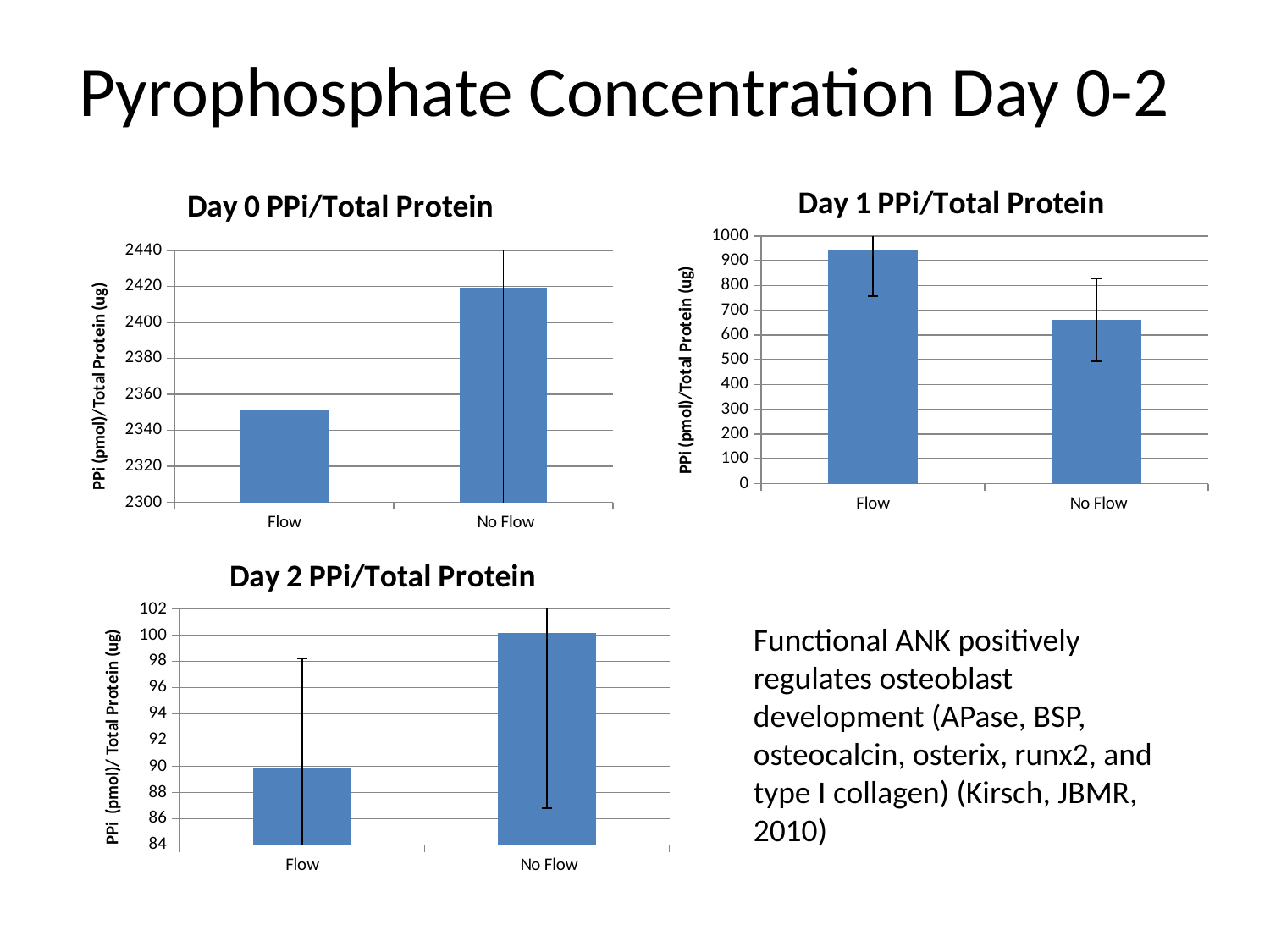
In the 'Day 1 PPi/Total Protein' chart, is the value for No Flow greater or less than 700? less How many charts are shown on the slide? 3 In the 'Day 2 PPi/Total Protein' chart, how many categories are shown on the x axis? 2 In the 'Day 2 PPi/Total Protein' chart, is the value for Flow greater or less than 92? less In the 'Day 0 PPi/Total Protein' chart, is the value for Flow greater or less than 2360? less In the 'Day 0 PPi/Total Protein' chart, what kind of chart is shown? bar chart In the 'Day 0 PPi/Total Protein' chart, which category has the higher value? No Flow In the 'Day 2 PPi/Total Protein' chart, which is larger, the value for Flow or the value for No Flow? No Flow In the 'Day 1 PPi/Total Protein' chart, which category has the lowest value? No Flow In the 'Day 1 PPi/Total Protein' chart, what is the y-axis label? PPi (pmol)/Total Protein (ug)